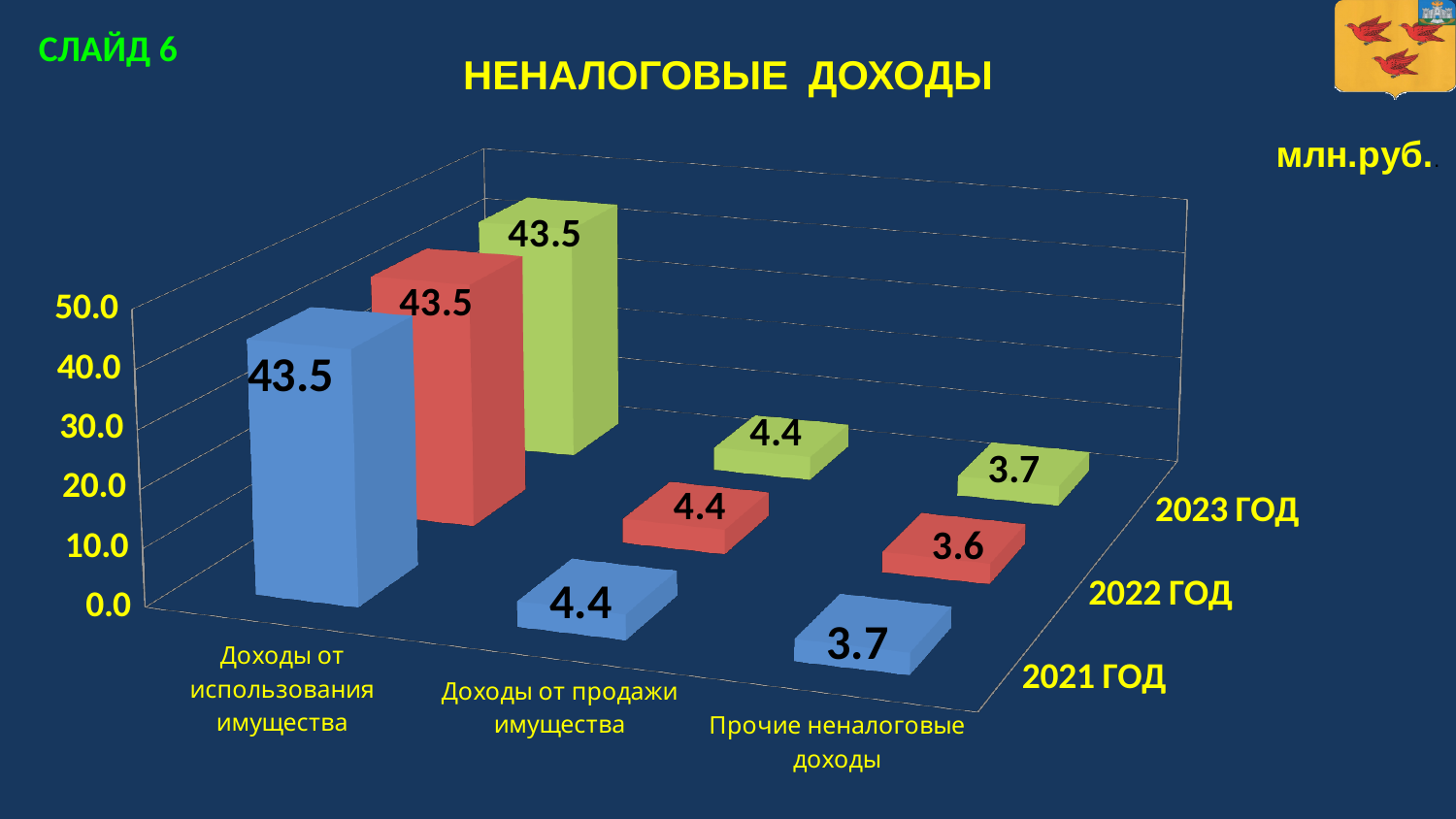
What is the value for Доходы от использования имущества in 2021 ГОД? 43.5 What is the difference between Доходы от использования имущества and Доходы от продажи имущества in 2021 ГОД? 39.1 How many categories are shown on the chart? 3 What is the value for Доходы от продажи имущества in 2023 ГОД? 4.4 Which is larger in 2023 ГОД: Доходы от продажи имущества or Прочие неналоговые доходы? Доходы от продажи имущества Which category has the highest value in 2022 ГОД? Доходы от использования имущества What is the difference between Прочие неналоговые доходы in 2021 ГОД and in 2022 ГОД? 0.1 What kind of chart is shown on the slide? bar chart What is the value for Прочие неналоговые доходы in 2023 ГОД? 3.7 What unit is indicated for the values on the chart? млн.руб. Which category has the lowest value in 2021 ГОД? Прочие неналоговые доходы What is the value for Прочие неналоговые доходы in 2022 ГОД? 3.6